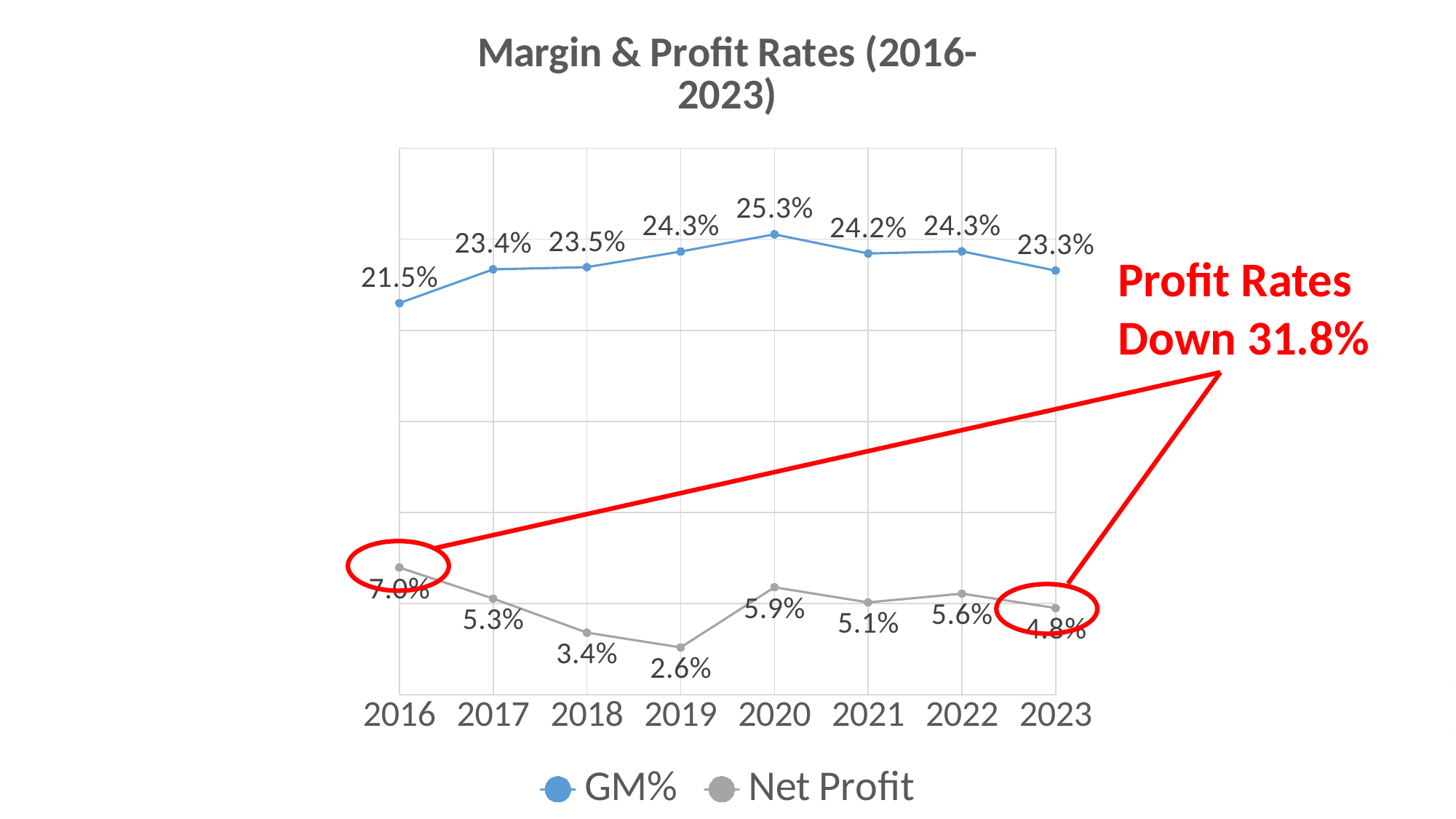
What kind of chart is shown? Line chart What is the GM% value for 2020? 25.3% What is the difference between the GM% values for 2020 and 2016? 3.8% In which year is GM% highest? 2020 What is the difference between the Net Profit values for 2016 and 2023? 2.2% How many years are plotted on the x axis? 8 Which is larger, the Net Profit value for 2020 or for 2021? 2020 What is the Net Profit value for 2019? 2.6% What is the GM% value for 2023? 23.3% What is the Net Profit value for 2016? 7.0% How many series does the legend list? 2 In which year is Net Profit lowest? 2019